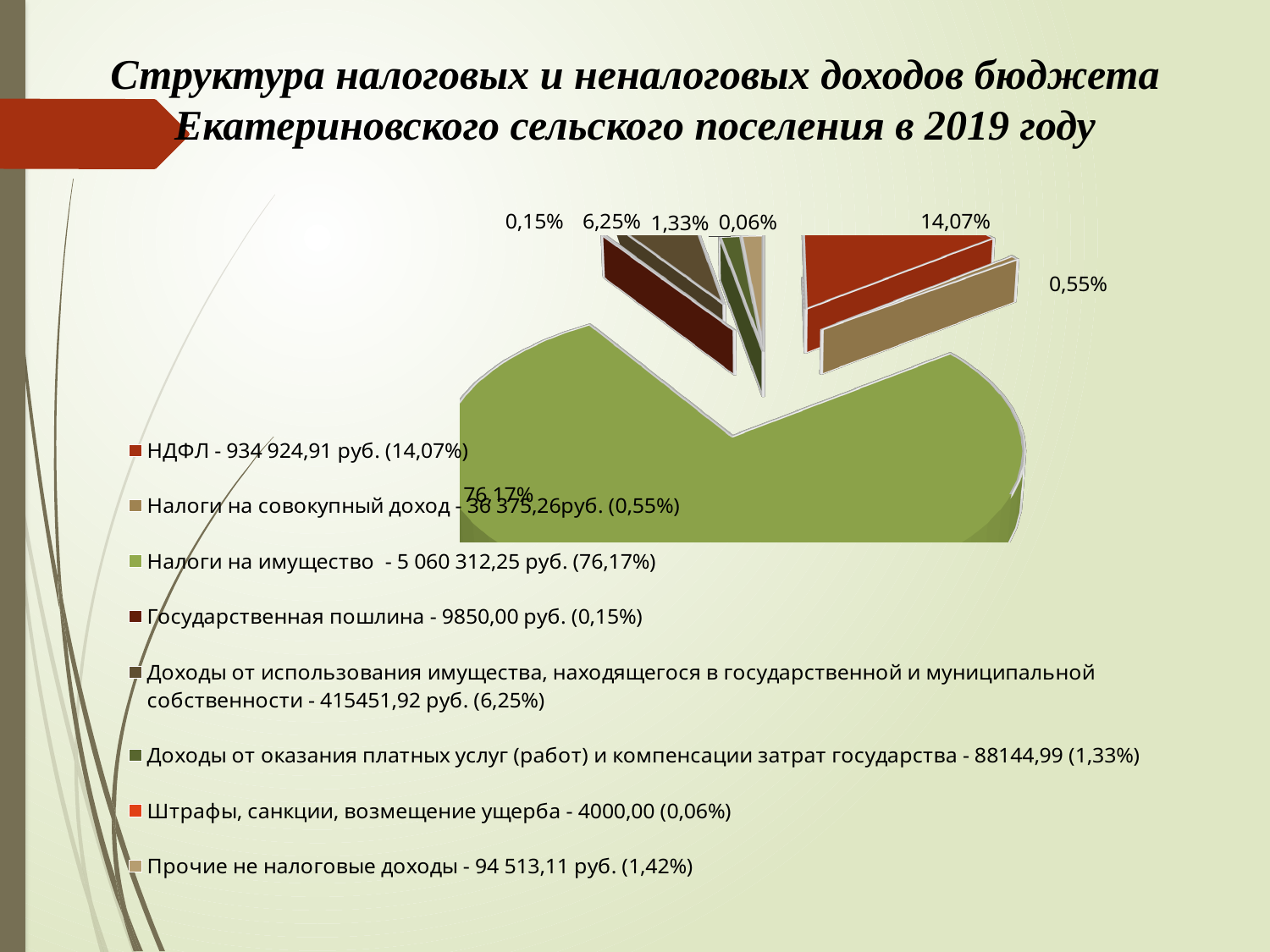
What percentage is shown for Государственная пошлина? 0,15% What kind of chart is shown on the slide? pie chart What percentage is shown for Доходы от использования имущества, находящегося в государственной и муниципальной собственности? 6,25% What is the difference in percentage points between the share for НДФЛ (14,07%) and the share for Налоги на совокупный доход (0,55%)? 13,52% How many entries does the chart legend list? 8 What is the difference in percentage points between the share for Доходы от использования имущества (6,25%) and the share for Доходы от оказания платных услуг (1,33%)? 4,92% Which is larger: the share for НДФЛ or the share for Доходы от оказания платных услуг (работ) и компенсации затрат государства? НДФЛ What share of the pie does НДФЛ have? 14,07% What year does the chart title refer to? 2019 Which category has the largest share of the pie? Налоги на имущество What percentage is shown for Налоги на совокупный доход? 0,55% Which category has the smallest share of the pie? Штрафы, санкции, возмещение ущерба